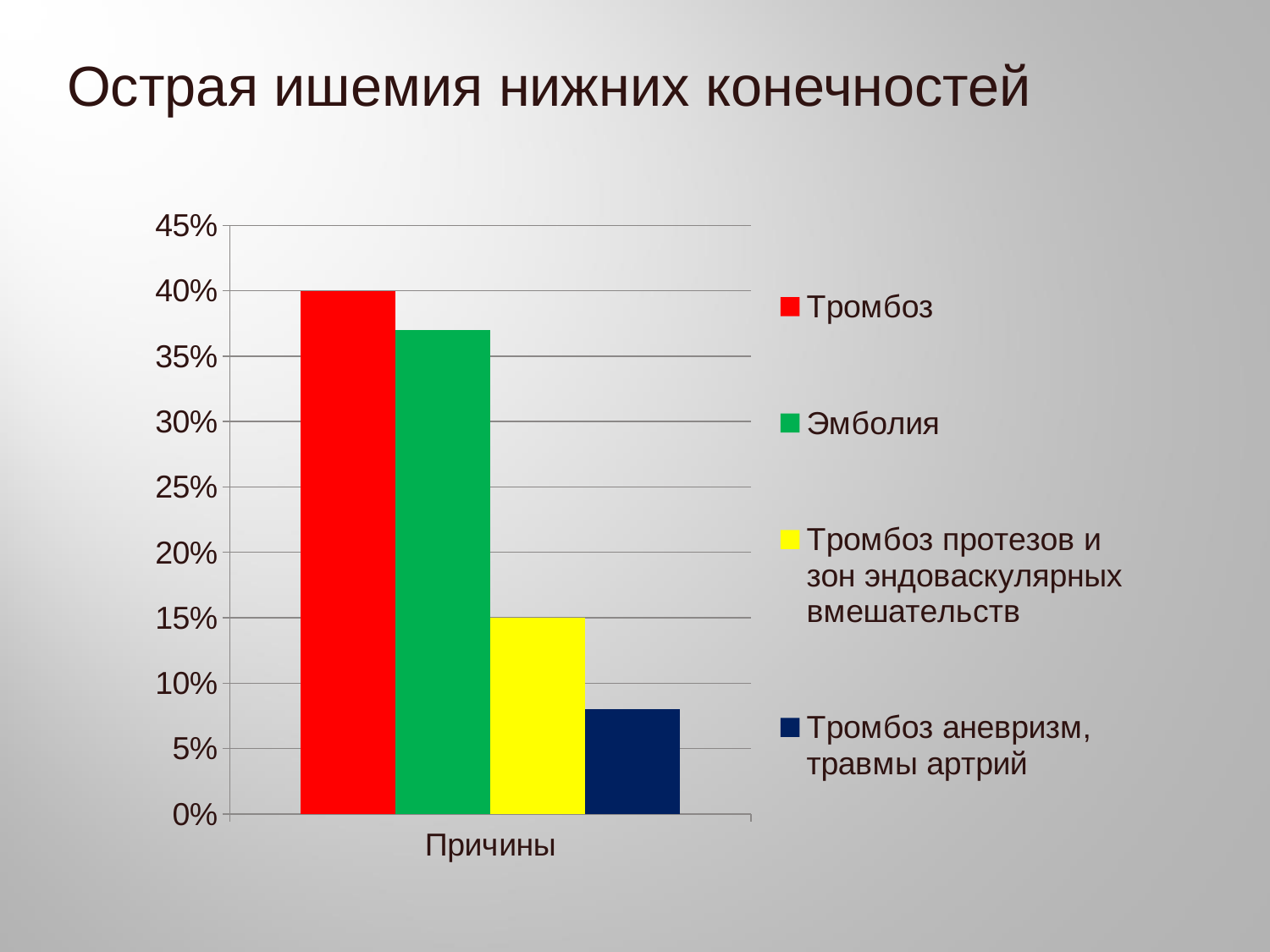
Which series has the lowest value? Тромбоз аневризм, травмы артрий Which series has the highest value? Тромбоз What is the value for Тромбоз? 40% What is the value for Тромбоз протезов и зон эндоваскулярных вмешательств? 15% Is the value for Эмболия greater or less than 35%? greater Is the value for Тромбоз аневризм, травмы артрий greater or less than 10%? less What colour is the bar for Эмболия? green What is the difference between the values for Тромбоз and Тромбоз протезов и зон эндоваскулярных вмешательств? 25% What is the title of the slide? Острая ишемия нижних конечностей Which is larger, the value for Тромбоз or the value for Эмболия? Тромбоз How many series does the legend list? 4 What kind of chart is shown on the slide? bar chart